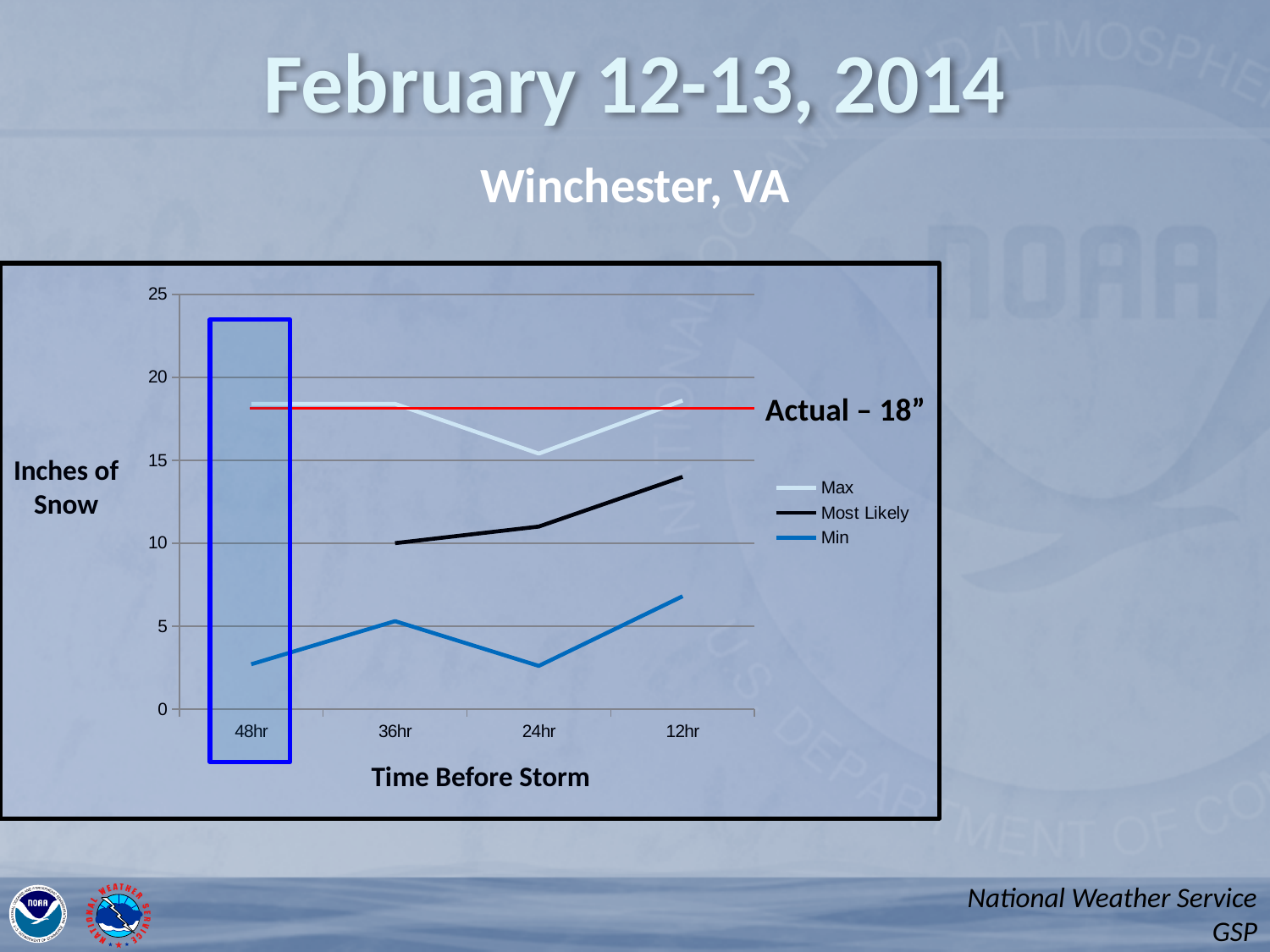
At 36hr, which is larger: the Max value or the Most Likely value? Max Is the Max value at 48hr greater or less than 20? less What actual snowfall amount is annotated on the chart? 18" At which time before the storm is the Max series lowest? 24hr How many series does the chart legend list? 3 Is the Most Likely value at 12hr greater or less than 10? greater How many time categories are shown on the x axis? 4 Is the Min value at 12hr greater or less than 10? less What kind of chart is shown on the slide? line chart Does the Most Likely series rise or fall from 36hr to 12hr? rise